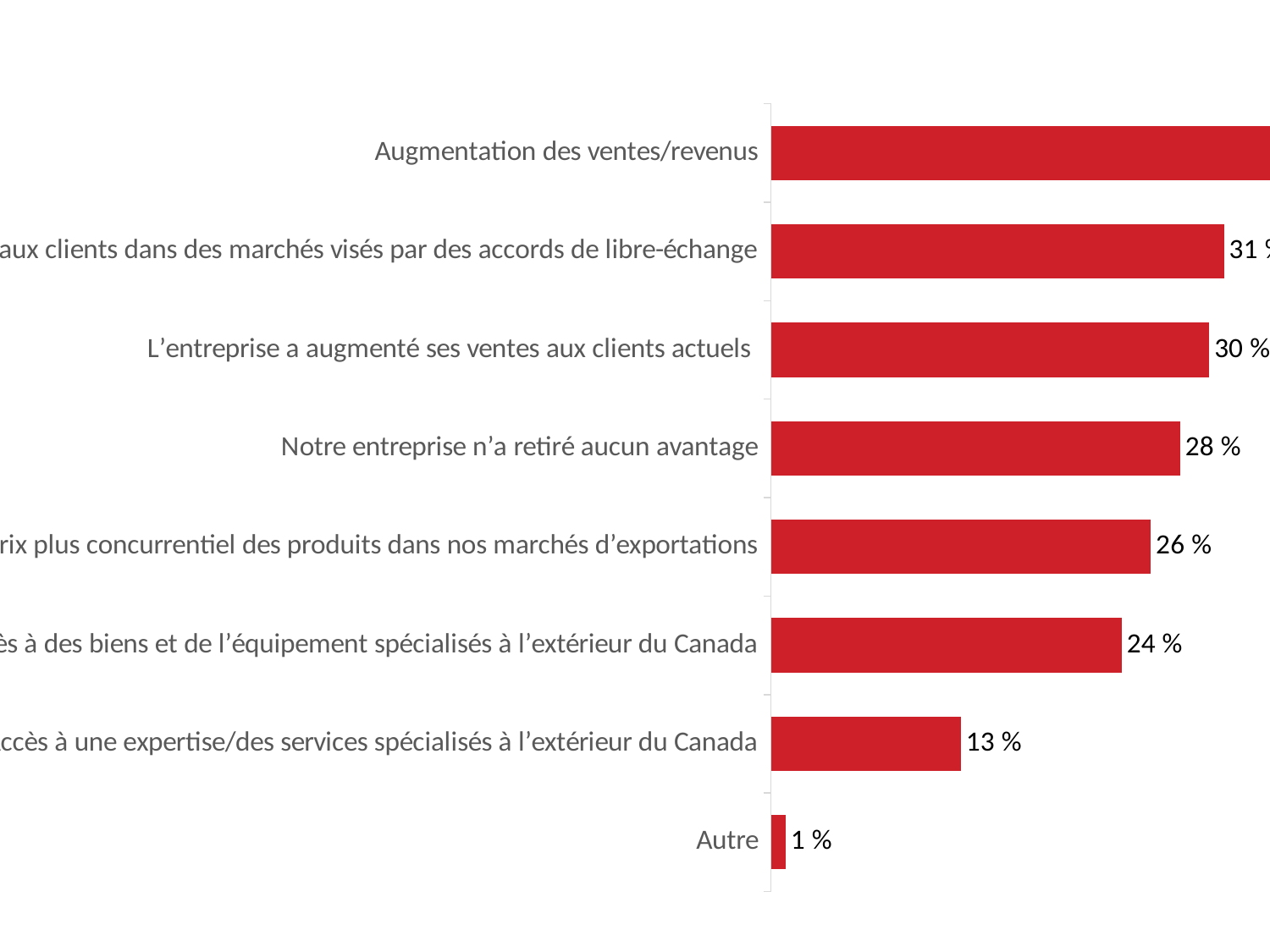
Which category has the longest bar? Augmentation des ventes/revenus What is the value for "L’entreprise a augmenté ses ventes aux clients actuels"? 30 % What is the difference between the values for "Notre entreprise n’a retiré aucun avantage" and "Autre"? 27 % What is the difference between the values for "L’entreprise a augmenté ses ventes aux clients actuels" and "Notre entreprise n’a retiré aucun avantage"? 2 % Which category has the lowest value? Autre What is the value for "Autre"? 1 % What kind of chart is shown on the slide? Bar chart What colour are the bars in the chart? Red Which is larger: the value for "Notre entreprise n’a retiré aucun avantage" or for "L’entreprise a augmenté ses ventes aux clients actuels"? L’entreprise a augmenté ses ventes aux clients actuels Which is larger: the value for "Augmentation des ventes/revenus" or for "Autre"? Augmentation des ventes/revenus How many categories are shown in the chart? 8 What is the value for "Notre entreprise n’a retiré aucun avantage"? 28 %